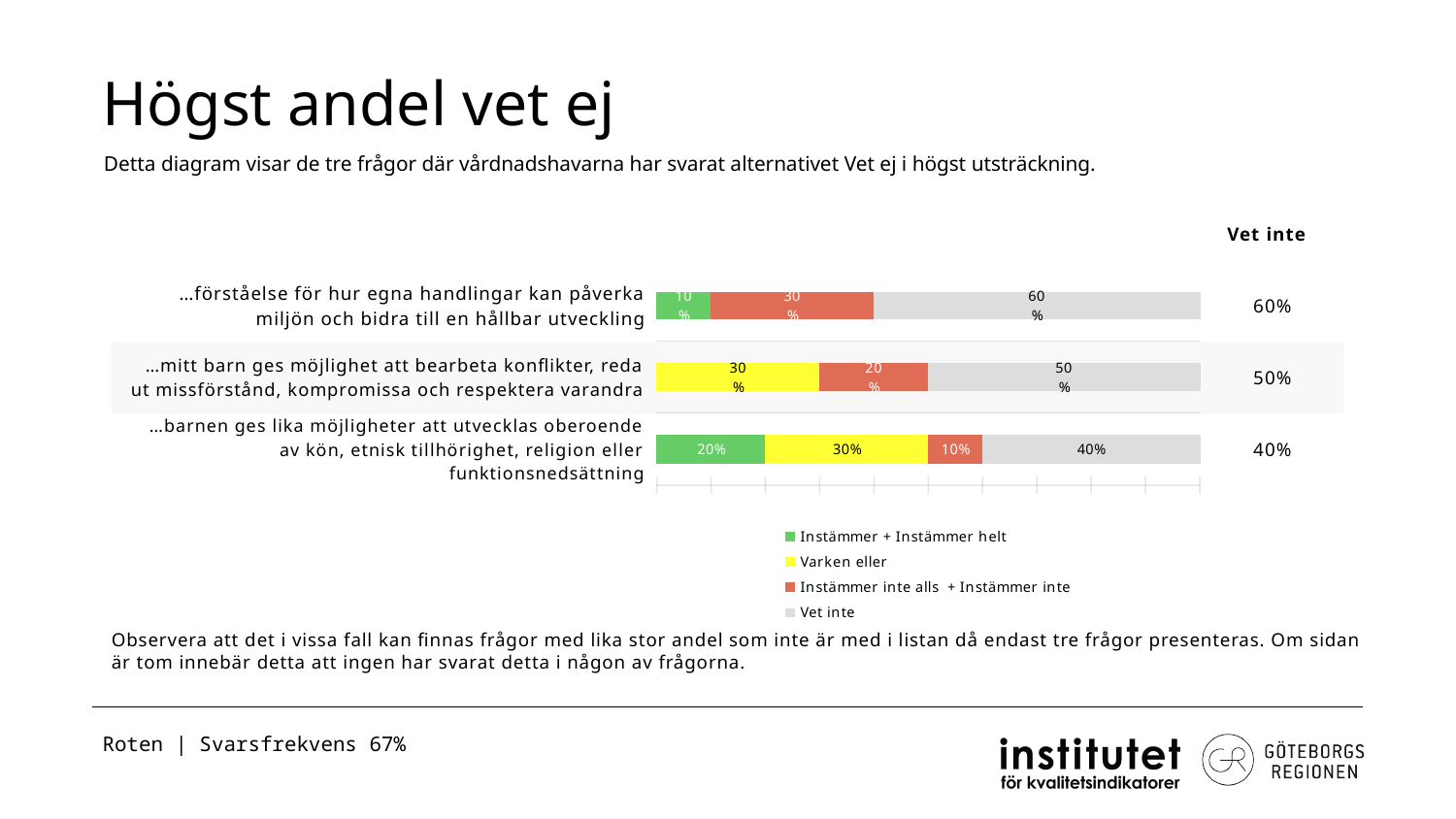
What is the 'Instämmer + Instämmer helt' share for the bottom question '…barnen ges lika möjligheter att utvecklas oberoende av kön, etnisk tillhörighet, religion eller funktionsnedsättning'? 20% How many series does the legend list? 4 What is the difference in 'Vet inte' share between the top question and the bottom question? 20% What kind of chart is shown on the slide? bar chart Which question has the highest 'Vet inte' share? …förståelse för hur egna handlingar kan påverka miljön och bidra till en hållbar utveckling Which legend entry is shown in grey? Vet inte What is the 'Vet inte' share for the question '…mitt barn ges möjlighet att bearbeta konflikter, reda ut missförstånd, kompromissa och respektera varandra'? 50% What is the 'Vet inte' share for the question '…förståelse för hur egna handlingar kan påverka miljön och bidra till en hållbar utveckling'? 60% Which question has the lowest 'Vet inte' share? …barnen ges lika möjligheter att utvecklas oberoende av kön, etnisk tillhörighet, religion eller funktionsnedsättning Is the 'Vet inte' share larger for the top question or the middle question? the top question What is the 'Varken eller' share for the question '…mitt barn ges möjlighet att bearbeta konflikter, reda ut missförstånd, kompromissa och respektera varandra'? 30% How many categories (questions) are plotted in the chart? 3